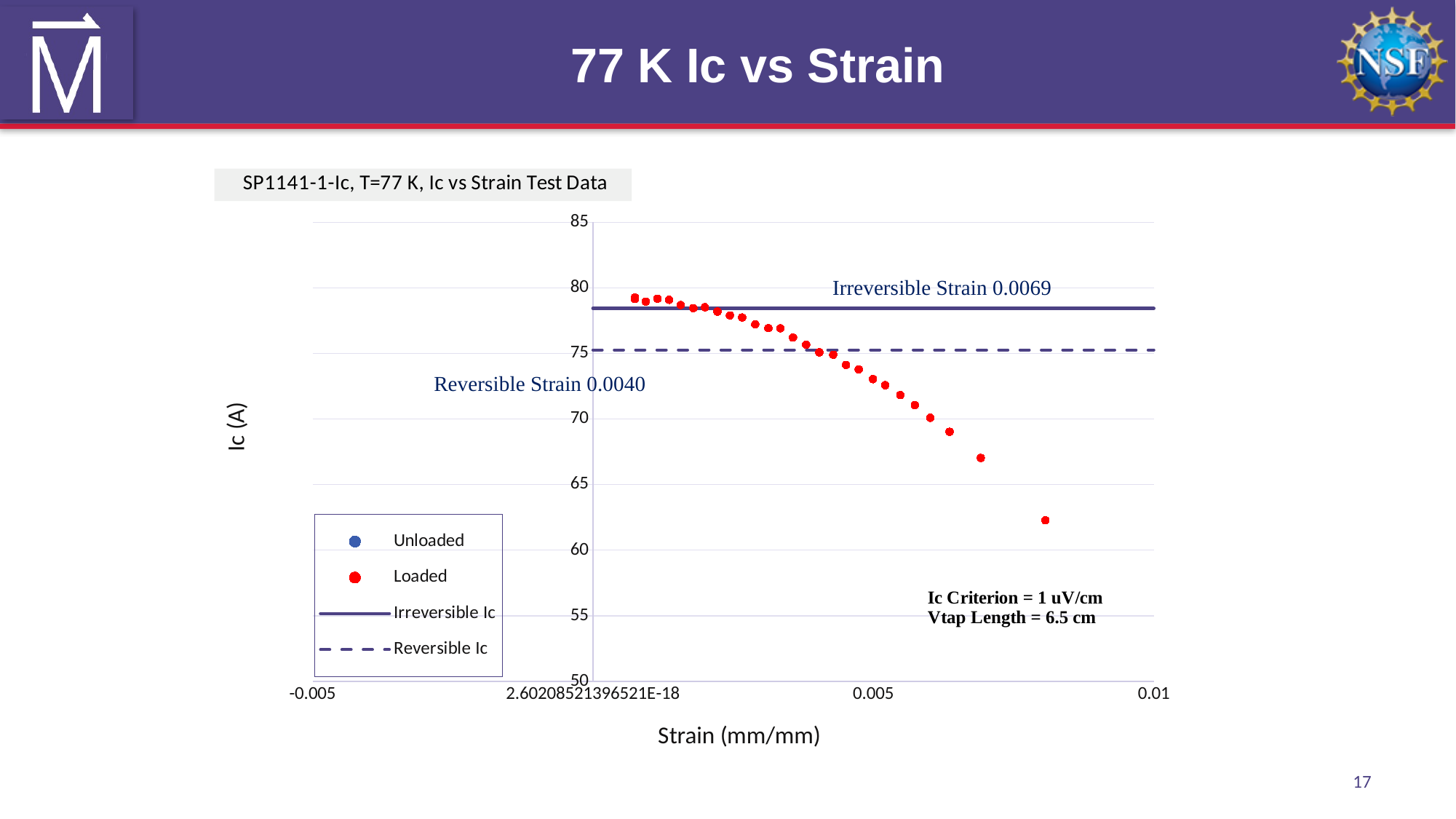
Which line sits higher on the chart, Irreversible Ic or Reversible Ic? Irreversible Ic Is the Loaded Ic value at a strain of 0.005 greater or less than 70? greater What Vtap length is stated on the chart? 6.5 cm What is the label of the y axis? Ic (A) How many entries does the chart legend list? 4 Do the Loaded Ic values rise or fall as strain increases along the x axis? fall What reversible strain value is annotated on the chart? 0.0040 Is the lowest Loaded Ic value on the chart greater or less than 65? less What irreversible strain value is annotated on the chart? 0.0069 What kind of chart is shown on the slide? scatter chart What is the title of the chart? SP1141-1-Ic, T=77 K, Ic vs Strain Test Data What Ic criterion is stated on the chart? 1 uV/cm